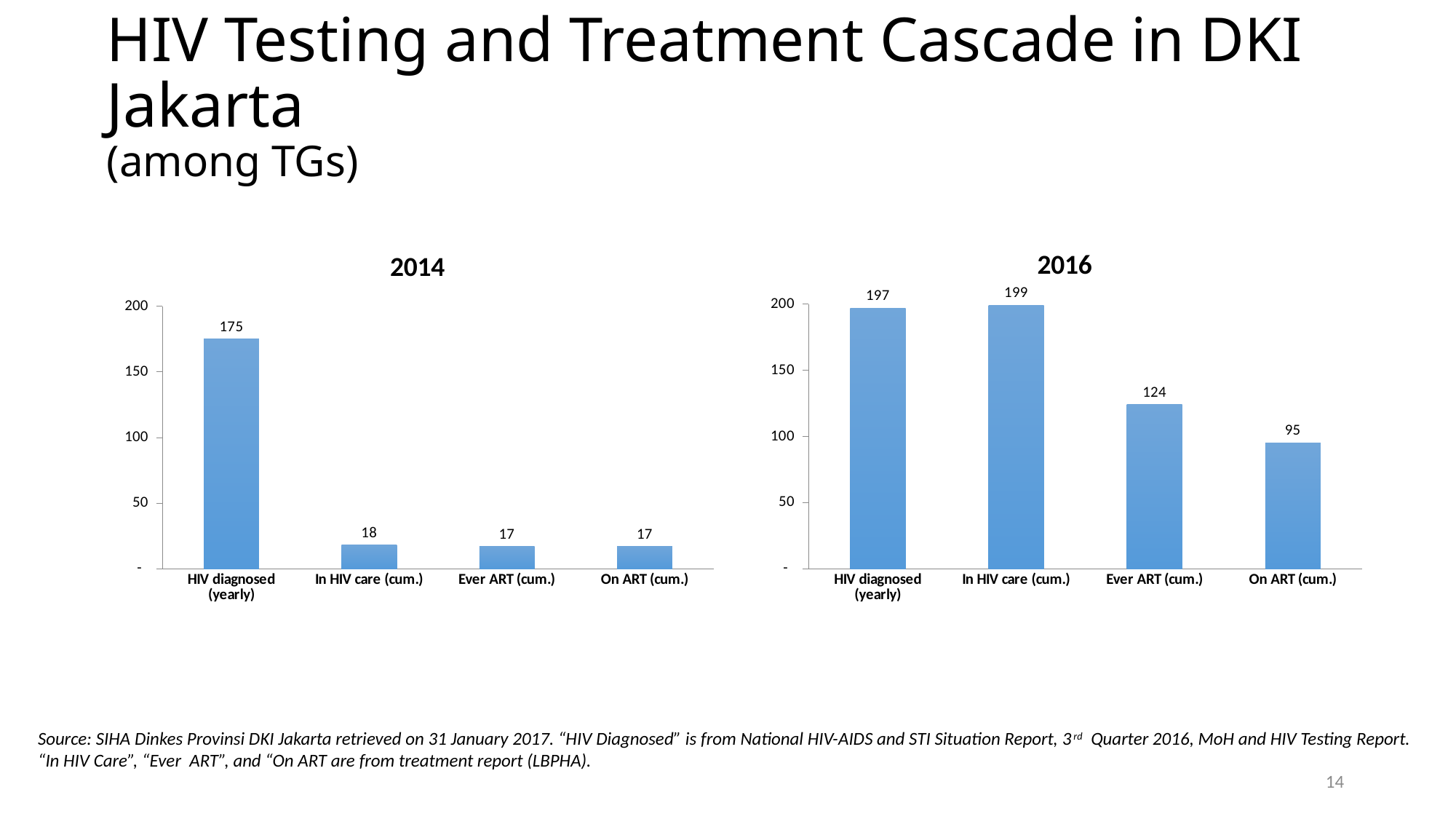
In the 2014 chart, which category has the highest value? HIV diagnosed (yearly) In the 2016 chart, what is the difference between HIV diagnosed (yearly) and On ART (cum.)? 102 In the 2016 chart, what is the value for Ever ART (cum.)? 124 In the 2014 chart, what is the value for HIV diagnosed (yearly)? 175 Which is larger: Ever ART (cum.) in the 2014 chart or Ever ART (cum.) in the 2016 chart? Ever ART (cum.) in the 2016 chart In the 2014 chart, what is the difference between HIV diagnosed (yearly) and In HIV care (cum.)? 157 In the 2016 chart, which category has the lowest value? On ART (cum.) In the 2014 chart, what is the value for In HIV care (cum.)? 18 In the 2016 chart, what is the value for On ART (cum.)? 95 How many categories are shown in the 2016 chart? 4 In the 2016 chart, which category has the highest value? In HIV care (cum.) What kind of chart is the 2014 chart? Bar chart